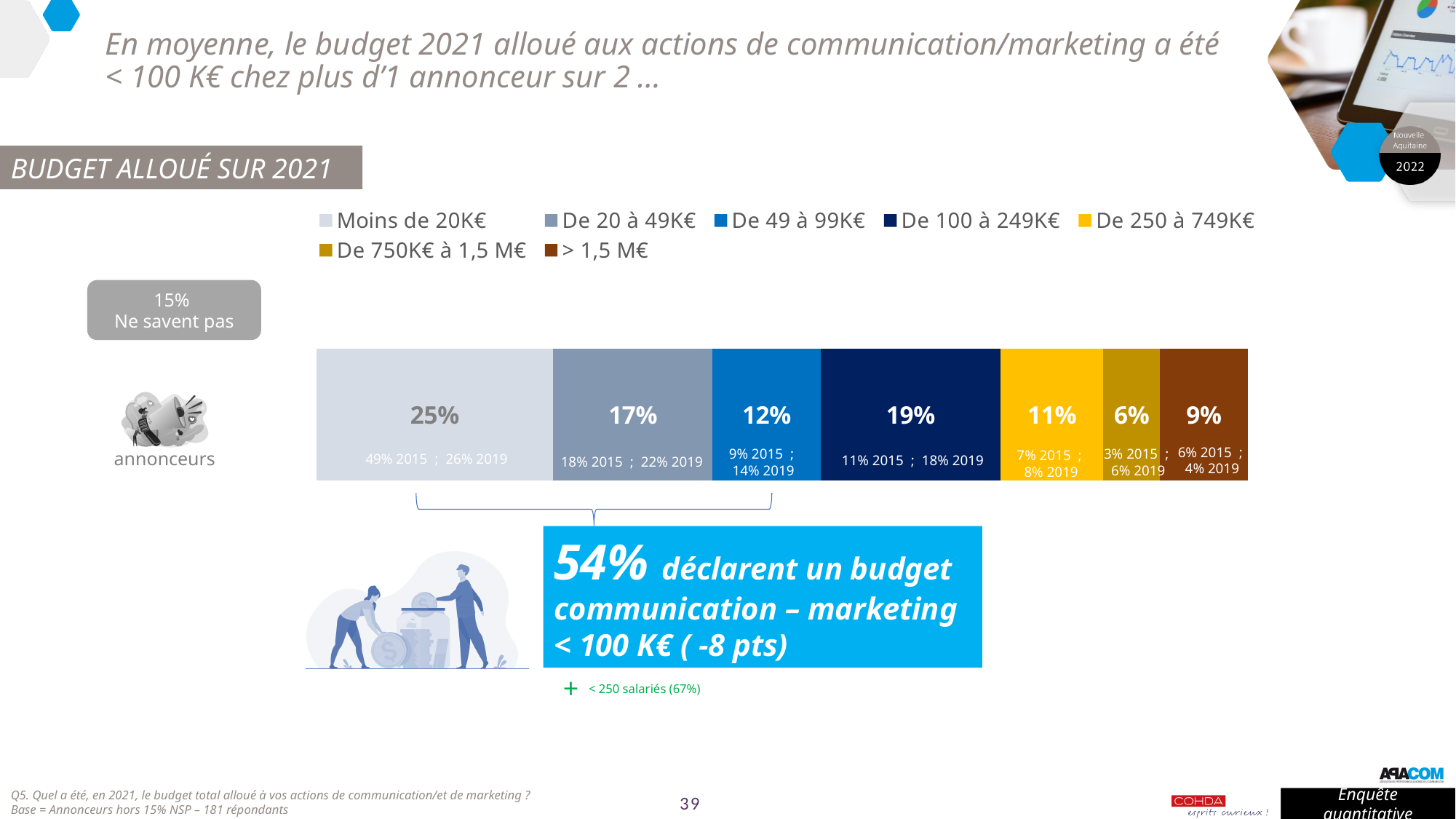
What percentage of advertisers fall in the 'De 100 à 249K€' budget category? 19% Which budget category has the largest share of advertisers? Moins de 20K€ What is the difference in percentage points between the 'Moins de 20K€' segment and the 'De 20 à 49K€' segment? 8 What was the share of advertisers with a budget under 20K€ in 2015, as noted in the chart? 49% What kind of chart is used to show the 2021 budget distribution? Stacked bar chart What is the value shown for the '> 1,5 M€' segment? 9% What is the combined share of the three segments below 100K€ (Moins de 20K€, De 20 à 49K€, De 49 à 99K€)? 54% Which budget category has the smallest share of advertisers? De 750K€ à 1,5 M€ What percentage of advertisers answered 'Ne savent pas' (don't know)? 15% Which is larger: the share for 'De 49 à 99K€' or the share for 'De 250 à 749K€'? De 49 à 99K€ What share of advertisers reported a 2021 communication/marketing budget of less than 20K€? 25% How many budget categories does the legend list? 7